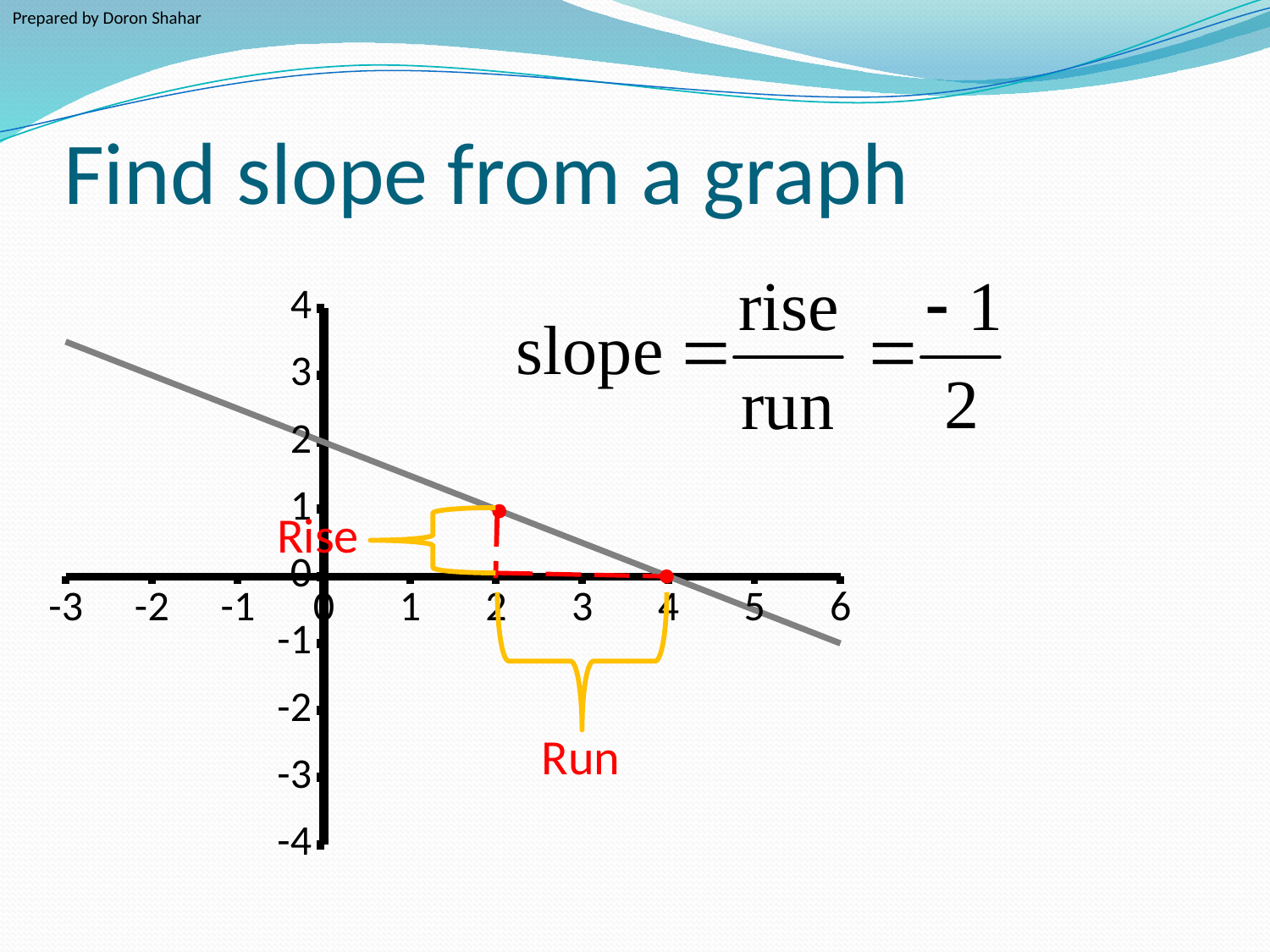
At what y-value does the line cross the y-axis? 2 What is the y-value of the marked point at x = 4? 0 Is the y-value of the line at x = 1 greater or less than 1? greater Which marked point has the larger y-value, the one at x = 2 or the one at x = 4? x = 2 What is the largest value labelled on the x-axis? 6 Does the plotted line rise or fall as x increases? fall What two words label the yellow braces on the graph? Rise and Run Is the y-value of the line at x = 5 greater or less than 0? less What is the y-value of the marked point at x = 2? 1 What slope value does the slide give for the line? -1/2 How many points are marked with red dots on the line? 2 What kind of chart is shown on the slide? line chart